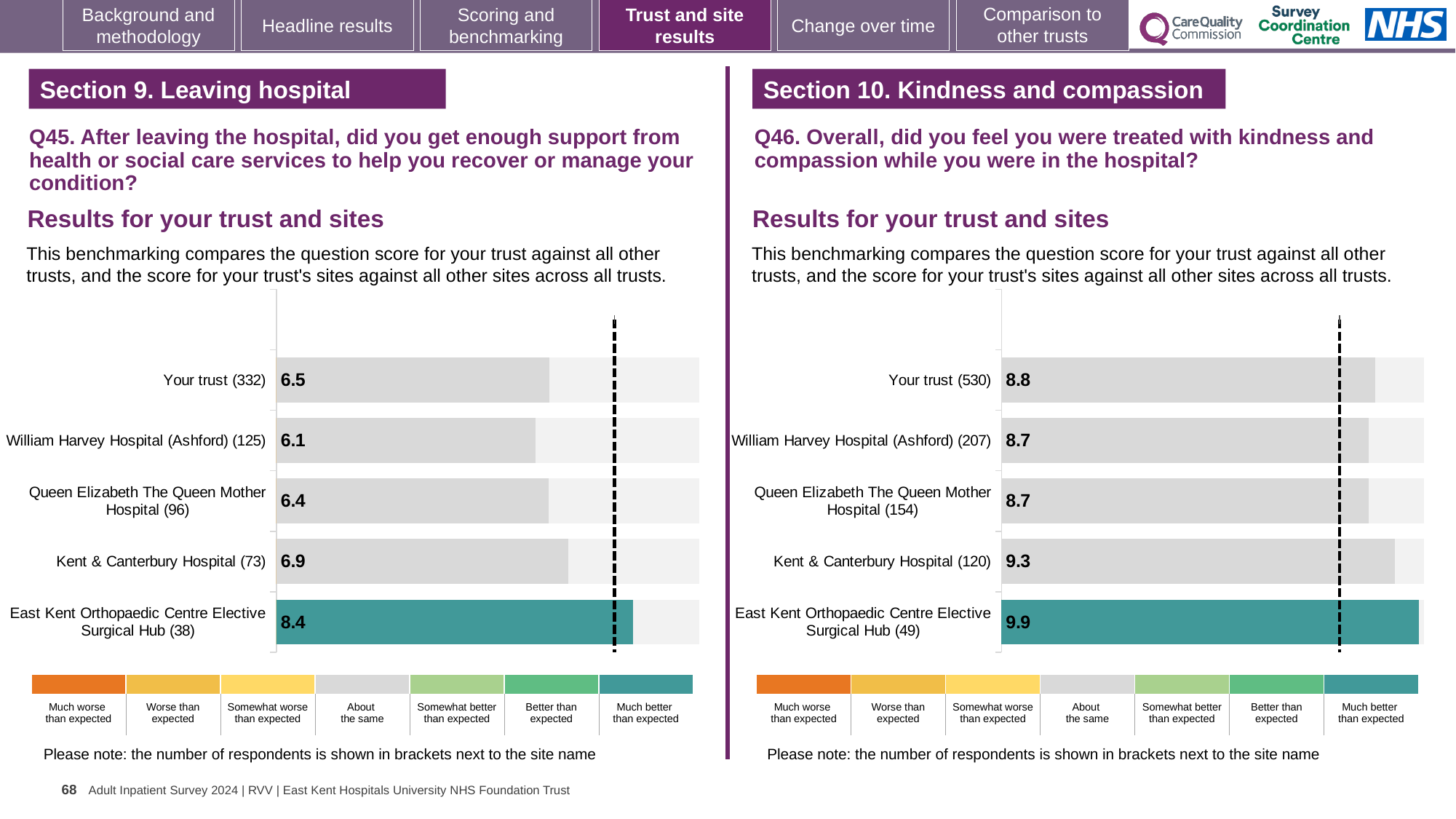
On the Q46 chart (right), what is the difference between the scores for East Kent Orthopaedic Centre Elective Surgical Hub and Kent & Canterbury Hospital? 0.6 On the Q45 chart (left), which site has the highest score? East Kent Orthopaedic Centre Elective Surgical Hub On the Q46 chart (right), what is the score for Your trust? 8.8 On the Q45 chart (left), what is the difference between the scores for East Kent Orthopaedic Centre Elective Surgical Hub and William Harvey Hospital (Ashford)? 2.3 On the Q45 chart (left), how many bars are plotted? 5 On the Q45 chart (left), which site has the lowest score? William Harvey Hospital (Ashford) On the Q45 chart (left), what is the score for Kent & Canterbury Hospital? 6.9 On the Q46 chart (right), which site has the highest score? East Kent Orthopaedic Centre Elective Surgical Hub On the Q46 chart (right), what is the score for Queen Elizabeth The Queen Mother Hospital? 8.7 What kind of chart is used on the Q46 chart (right)? Bar chart On the Q45 chart (left), what is the score for Your trust? 6.5 On the Q46 chart (right), which is larger: the score for Kent & Canterbury Hospital or the score for Your trust? Kent & Canterbury Hospital